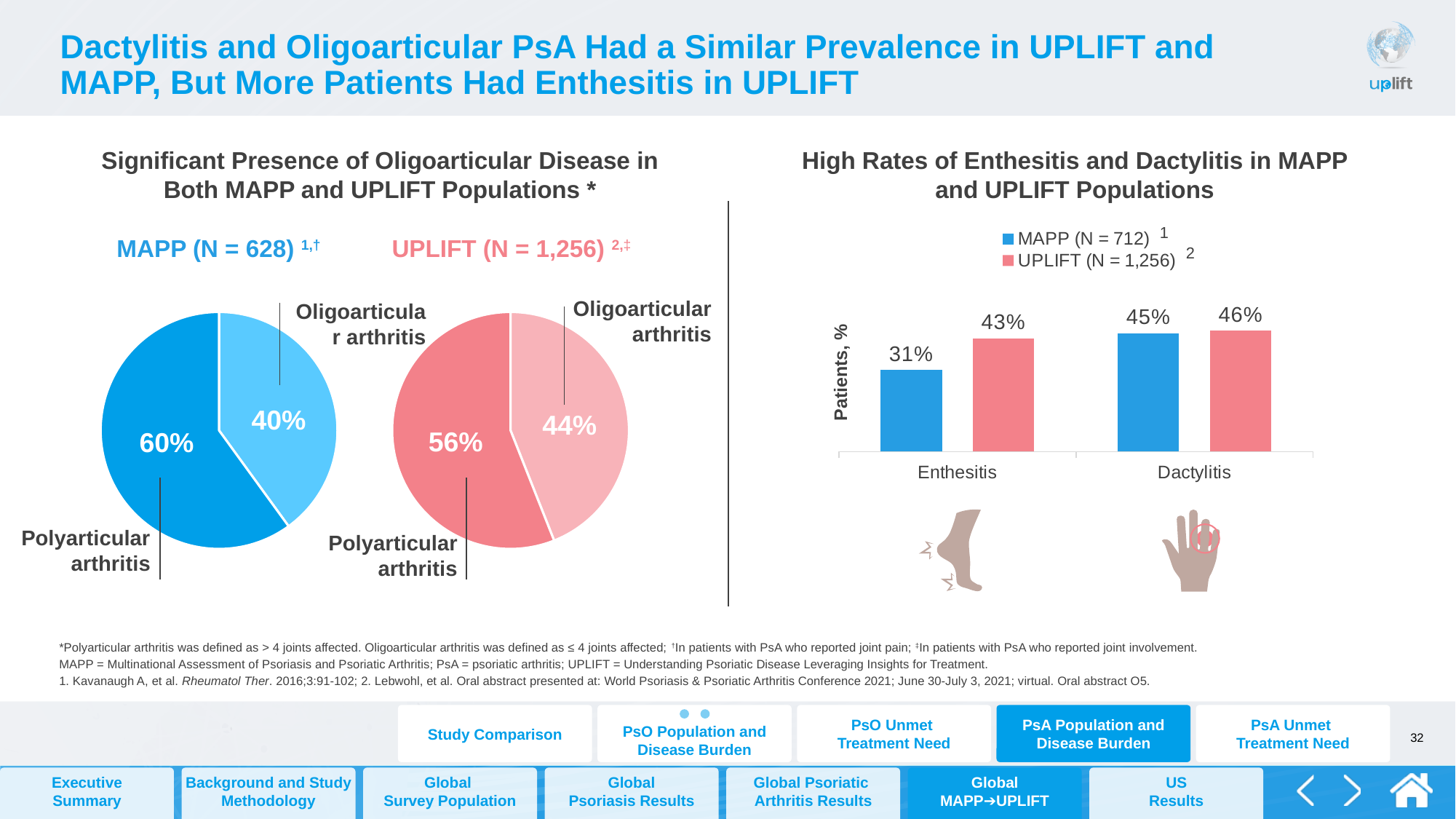
In the UPLIFT (N = 1,256) pie chart, what percentage of patients had polyarticular arthritis? 56% In the bar chart titled 'High Rates of Enthesitis and Dactylitis in MAPP and UPLIFT Populations', what is the difference between the UPLIFT and MAPP values for Enthesitis? 12% How many series does the legend of the bar chart titled 'High Rates of Enthesitis and Dactylitis in MAPP and UPLIFT Populations' list? 2 In the bar chart titled 'High Rates of Enthesitis and Dactylitis in MAPP and UPLIFT Populations', what is the value for Dactylitis in UPLIFT? 46% What type of chart is used to show the prevalence of oligoarticular and polyarticular arthritis in MAPP and UPLIFT? Pie chart In the UPLIFT (N = 1,256) pie chart, what percentage of patients had oligoarticular arthritis? 44% In the bar chart titled 'High Rates of Enthesitis and Dactylitis in MAPP and UPLIFT Populations', what is the value for Enthesitis in MAPP? 31% In the bar chart titled 'High Rates of Enthesitis and Dactylitis in MAPP and UPLIFT Populations', which bar is the lowest? Enthesitis, MAPP (31%) In the MAPP (N = 628) pie chart, what percentage of patients had oligoarticular arthritis? 40% What is the difference between the oligoarticular arthritis share in the UPLIFT pie chart and in the MAPP pie chart? 4% In the UPLIFT (N = 1,256) pie chart, which slice is larger, polyarticular arthritis or oligoarticular arthritis? Polyarticular arthritis In the MAPP (N = 628) pie chart, what percentage of patients had polyarticular arthritis? 60%